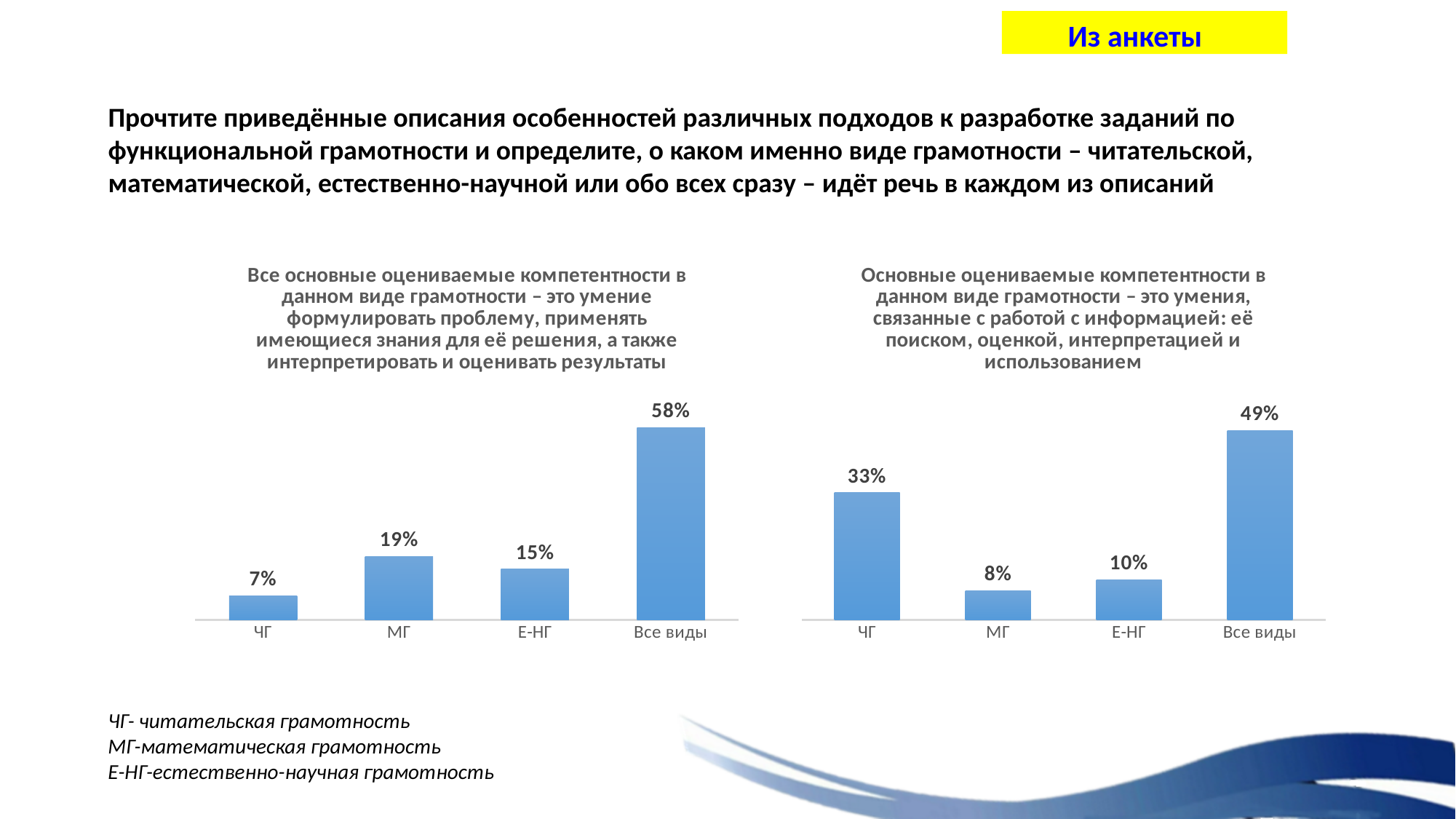
In the right chart, which category has the lowest value? МГ In the right chart, which is larger: the value for Е-НГ or the value for МГ? Е-НГ In the right chart, what is the value for ЧГ? 33% In the left chart, which category has the lowest value? ЧГ In the right chart, what is the difference between the values for Все виды and ЧГ? 16% In the left chart, which category has the highest value? Все виды In the left chart, what is the value for Е-НГ? 15% In the left chart, what is the difference between the values for МГ and ЧГ? 12% In the left chart, what is the value for МГ? 19% In the right chart, what is the value for Все виды? 49% What type of chart is the right chart? Bar chart How many categories are shown in the left chart? 4